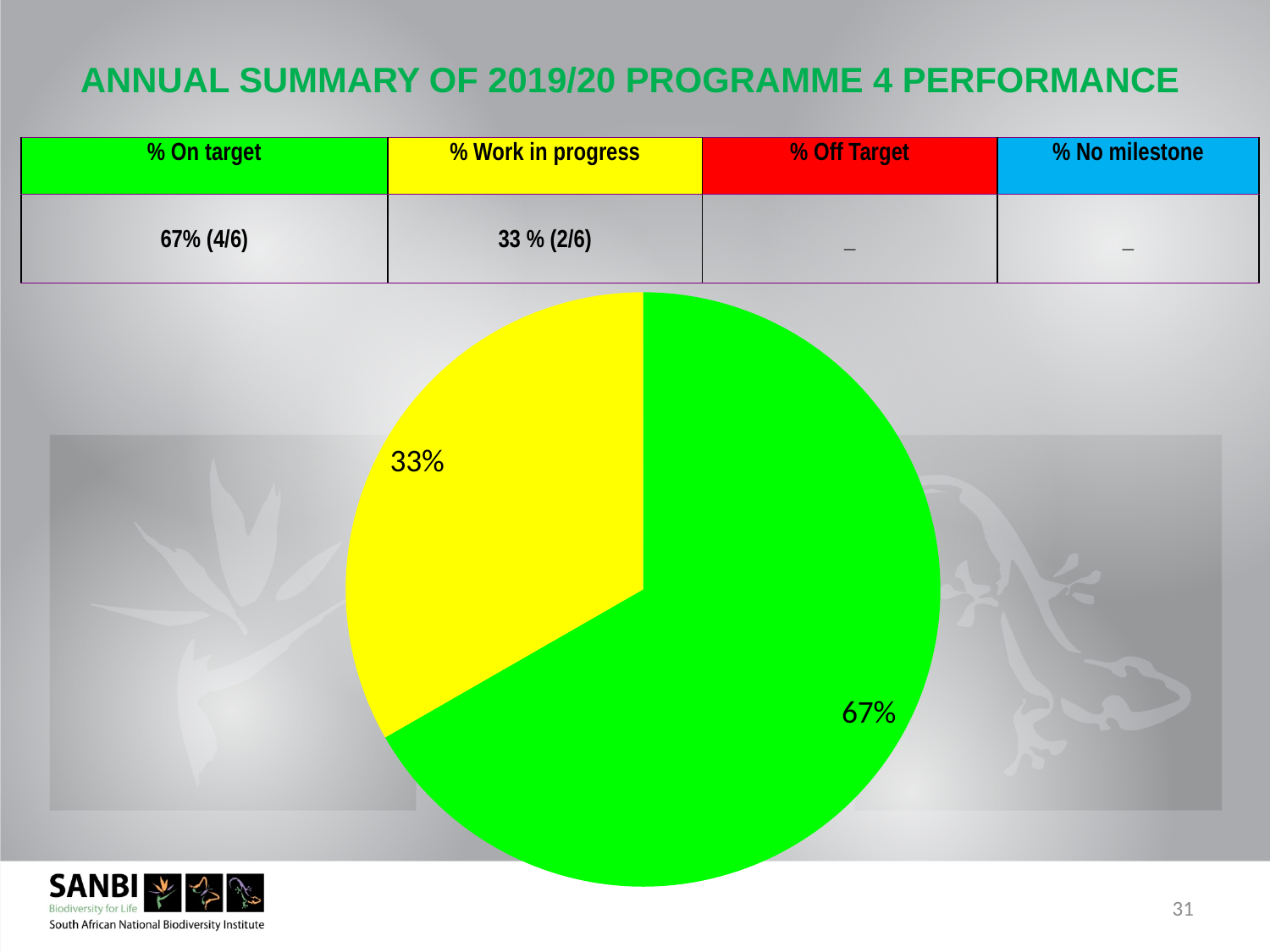
Which slice of the pie chart is the smallest? the yellow slice (33%) According to the table above the pie chart, which status category does the yellow colour represent? % Work in progress Is the green slice or the yellow slice of the pie chart larger? the green slice According to the table above the pie chart, which status category does the green colour represent? % On target What percentage is shown on the green slice of the pie chart? 67% What is the difference between the green slice and the yellow slice of the pie chart? 34% Is the value of the green slice greater or less than 50%? greater Which slice of the pie chart is the largest? the green slice (67%) What percentage is shown on the yellow slice of the pie chart? 33% How many slices does the pie chart have? 2 What kind of chart is shown on the slide? pie chart What share of the pie does the yellow slice represent? 33%